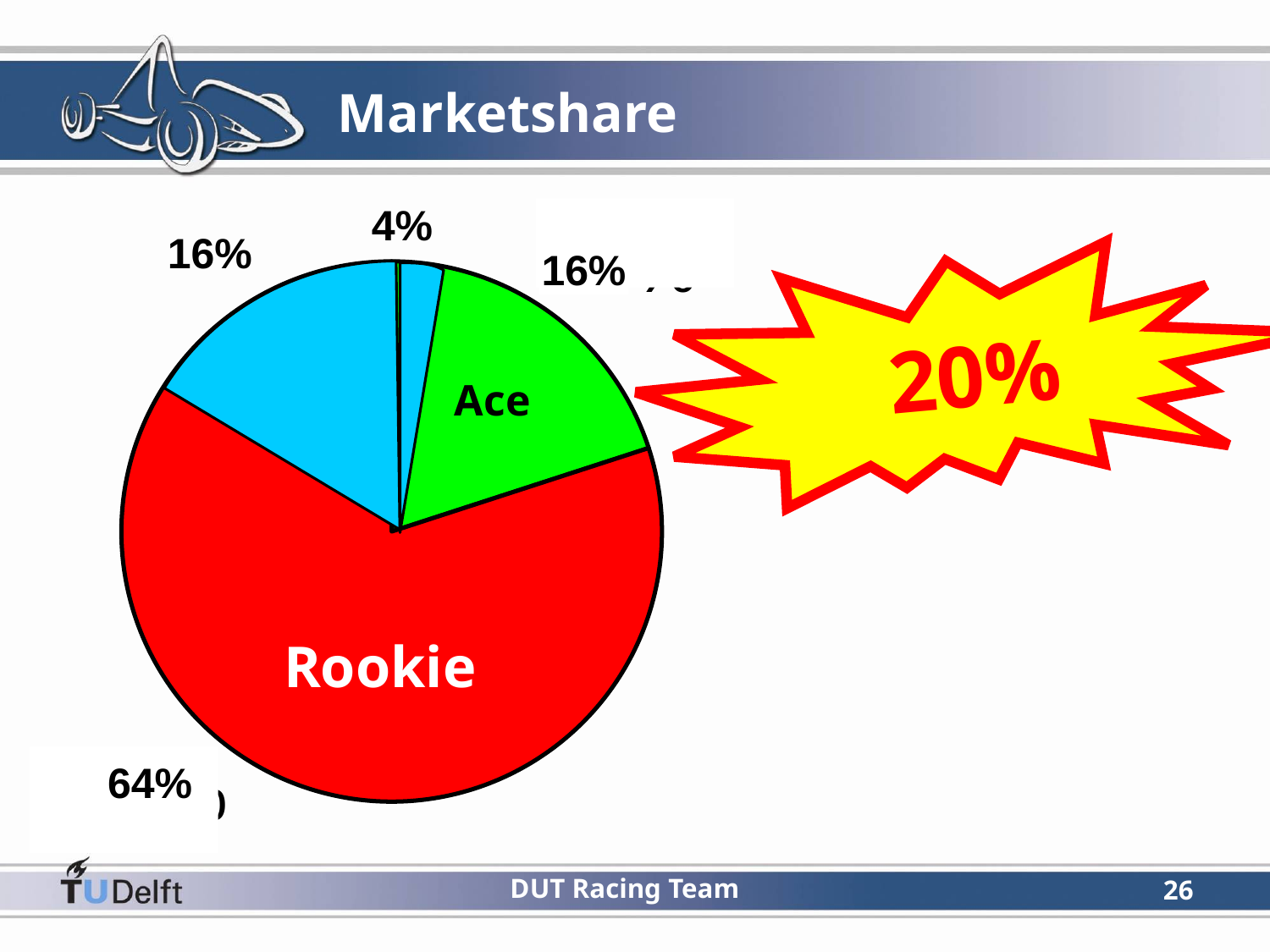
Which is larger, the Rookie slice or the Ace slice? Rookie What share of the pie does the Ace slice have? 16% What kind of chart is shown on the slide? pie chart Is the share of the Rookie slice greater or less than 50%? greater What is the title of the chart on the slide? Marketshare What is the smallest percentage label shown on the pie chart? 4% What is the difference in percentage points between the Rookie slice and the Ace slice? 48% What share of the pie does the Rookie slice have? 64% What colour is the Rookie slice of the pie? red Which slice of the pie is the largest? Rookie